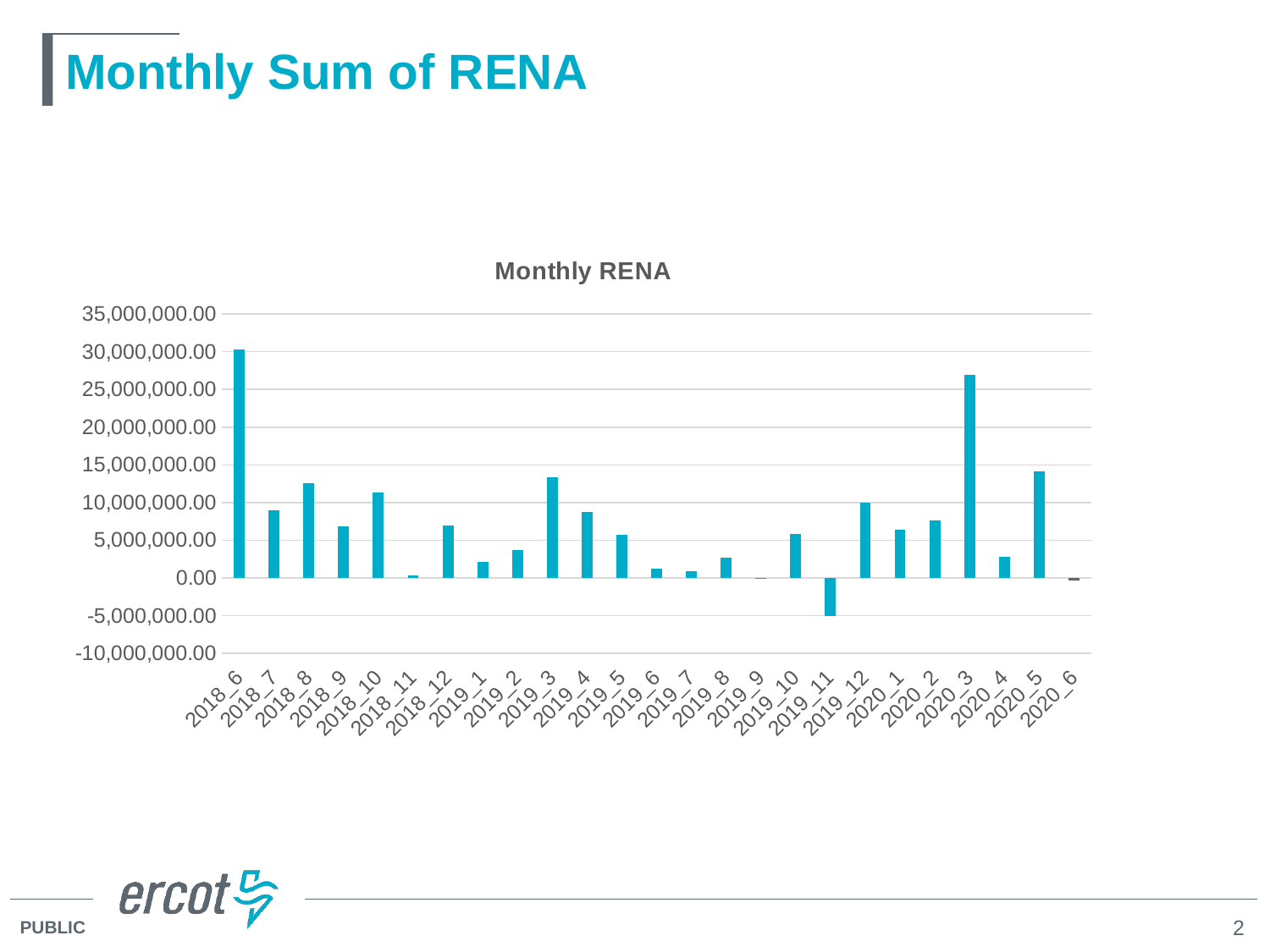
Is the value for 2020_3 greater or less than 25,000,000.00? greater Which month has the highest Monthly RENA value? 2018_6 What type of chart is shown on the slide? Bar chart Which is larger, the value for 2019_3 or the value for 2019_4? 2019_3 Which is larger, the value for 2020_5 or the value for 2019_12? 2020_5 Is the value for 2018_6 greater or less than 25,000,000.00? greater Is the value for 2019_6 greater or less than 5,000,000.00? less What is the title of the chart? Monthly RENA Which month has the lowest Monthly RENA value? 2019_11 How many months (categories) are plotted on the x axis? 25 Which is larger, the value for 2018_6 or the value for 2020_3? 2018_6